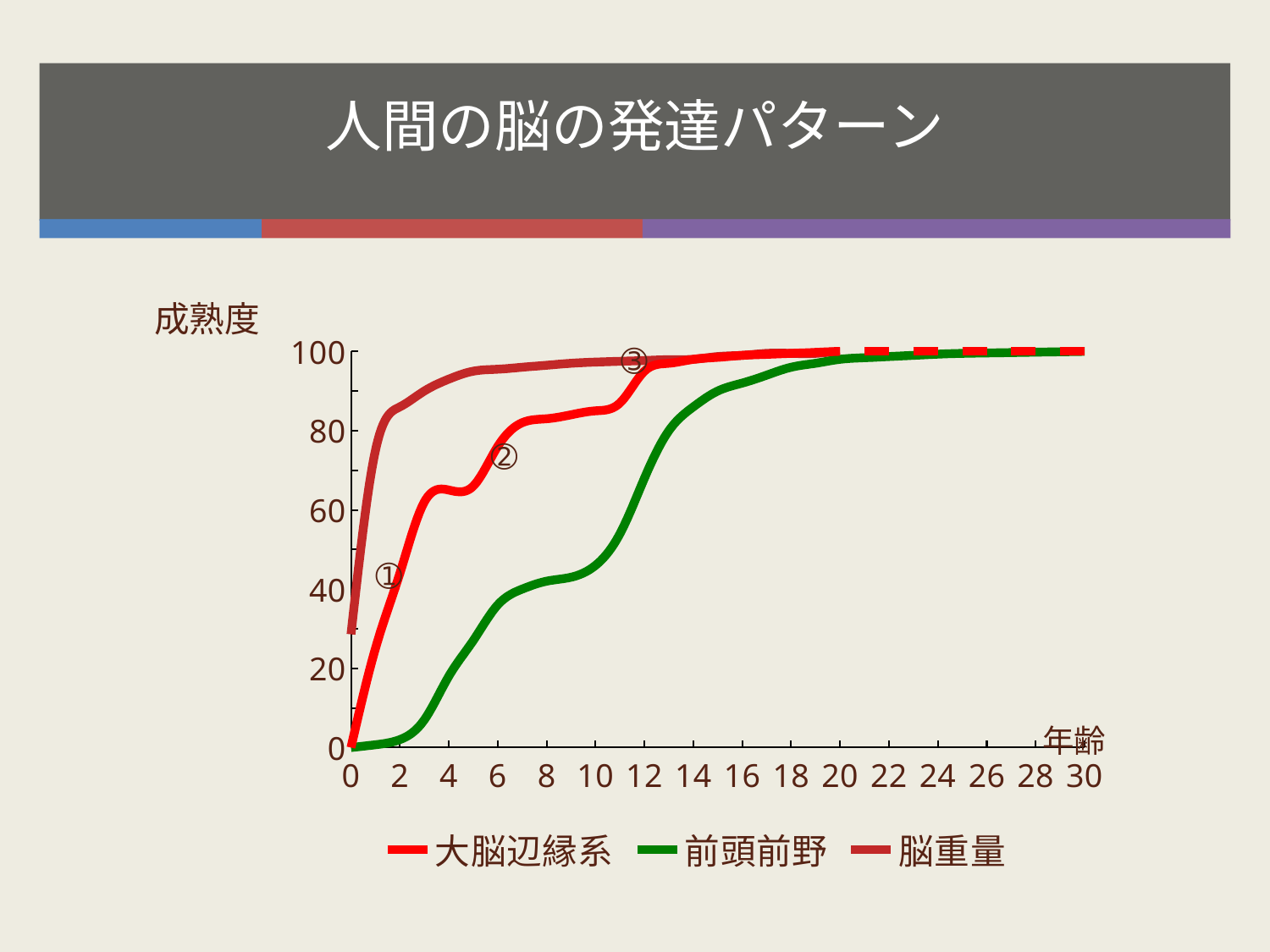
Is the value for 前頭前野 at age 2 greater or less than 20? less Is the value for 前頭前野 at age 10 greater or less than 60? less Is the value for 大脳辺縁系 at age 6 greater or less than 60? greater What is the label on the vertical axis? 成熟度 What is the title of the chart? 人間の脳の発達パターン Which series has the lowest value at age 6? 前頭前野 How many series does the legend list? 3 What kind of chart is shown on the slide? line chart At age 2, which series has the higher value, 脳重量 or 大脳辺縁系? 脳重量 At age 10, which series has the higher value, 大脳辺縁系 or 前頭前野? 大脳辺縁系